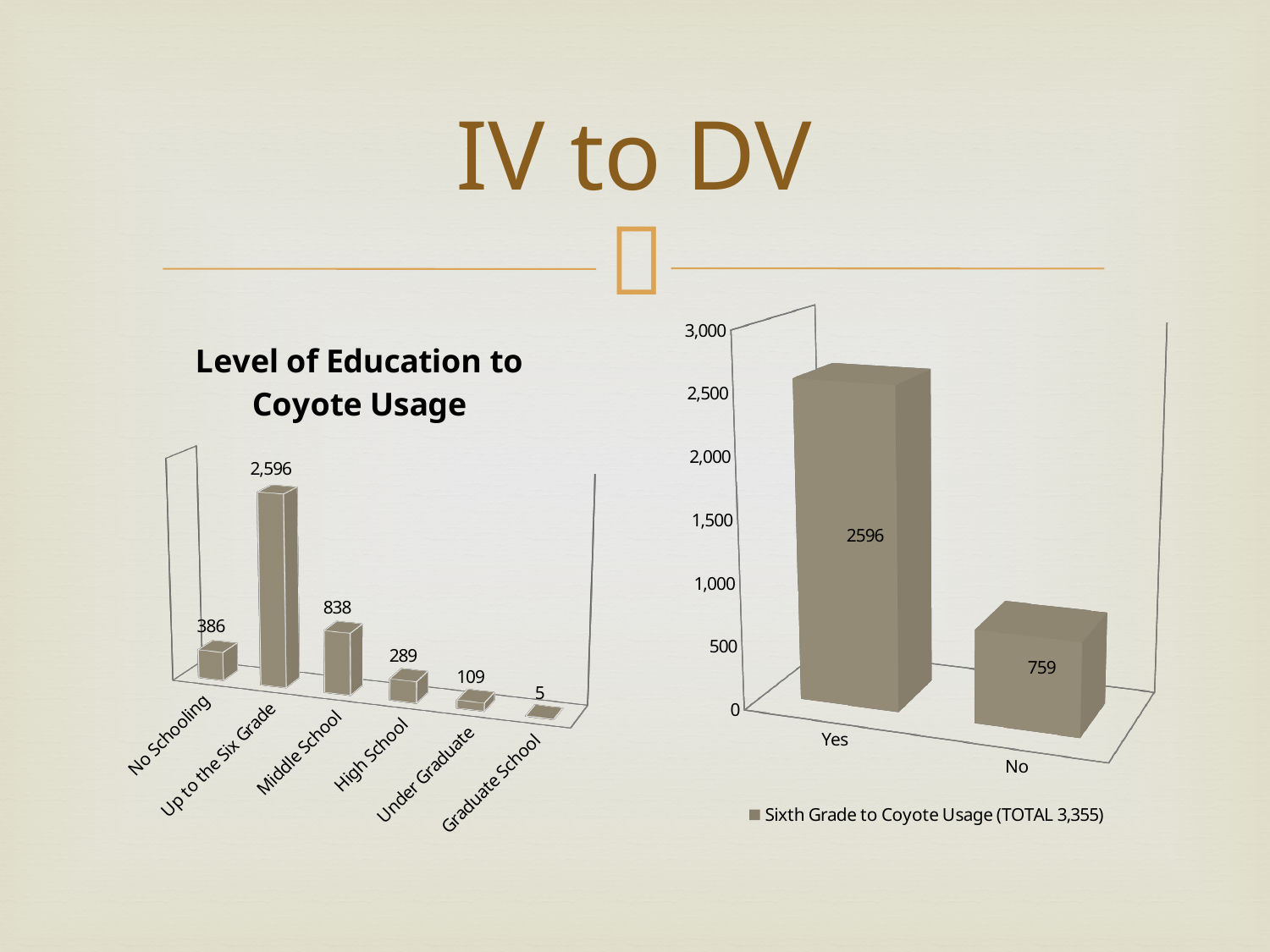
How many categories are shown in the 'Level of Education to Coyote Usage' chart? 6 In the chart on the right of the slide, what is the value for No? 759 In the chart on the right of the slide, what is the difference between the values for Yes and No? 1837 In the chart on the right of the slide, is the value for Yes greater or less than 2,500? greater In the 'Level of Education to Coyote Usage' chart, what is the difference between the values for Middle School and High School? 549 What kind of chart is the 'Level of Education to Coyote Usage' chart? Bar chart In the 'Level of Education to Coyote Usage' chart, which category has the lowest value? Graduate School In the 'Level of Education to Coyote Usage' chart, which category has the highest value? Up to the Six Grade In the 'Level of Education to Coyote Usage' chart, which is larger, No Schooling or High School? No Schooling In the 'Level of Education to Coyote Usage' chart, what is the value for Middle School? 838 In the 'Level of Education to Coyote Usage' chart, what is the value for Under Graduate? 109 What is the legend entry shown under the chart on the right of the slide? Sixth Grade to Coyote Usage (TOTAL 3,355)